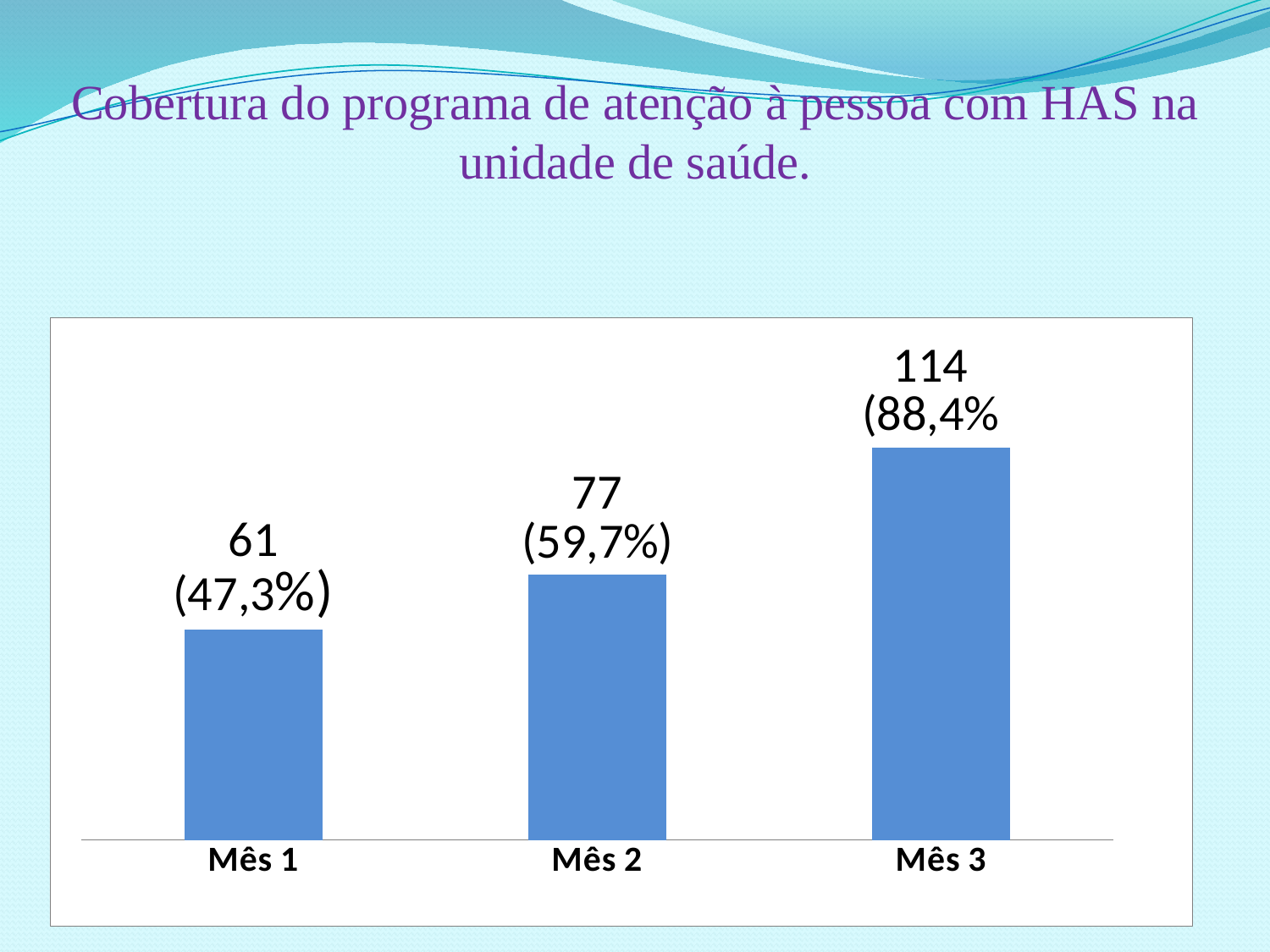
Do the values rise or fall from Mês 1 to Mês 3? Rise What is the value for Mês 3? 114 (88,4%) Which is larger, the value for Mês 2 or Mês 3? Mês 3 Which month has the highest value? Mês 3 What is the difference between the counts for Mês 3 and Mês 1? 53 What percentage is shown for Mês 2? 59,7% How many months are shown on the chart? 3 What is the value for Mês 1? 61 (47,3%) Which month has the lowest value? Mês 1 What kind of chart is shown on the slide? Bar chart What is the difference between the counts for Mês 2 and Mês 1? 16 What is the value for Mês 2? 77 (59,7%)